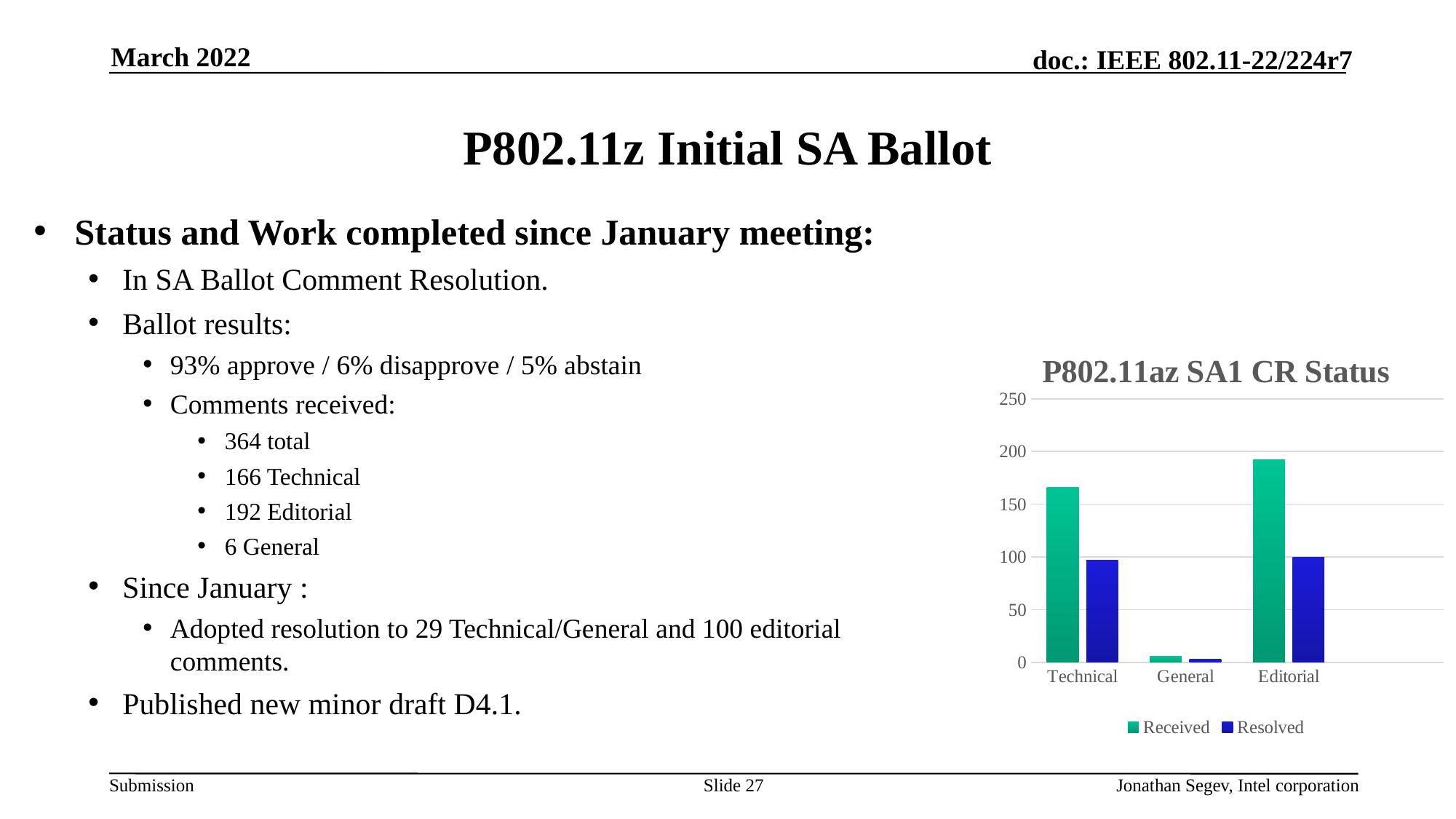
For Technical, which is larger: Received or Resolved? Received How many series does the chart's legend list? 2 Is the Received value for Technical greater or less than 150? greater Which category has the lowest Received value? General Is the Received value for Editorial greater or less than 200? less Which category has the highest Received value? Editorial What kind of chart is shown on the slide? bar chart Is the Resolved value for Technical greater or less than 50? greater What is the title of the chart? P802.11az SA1 CR Status What are the two series named in the legend? Received and Resolved How many categories are shown on the x axis of the chart? 3 Which is larger: the Received value for Editorial or the Received value for Technical? Editorial